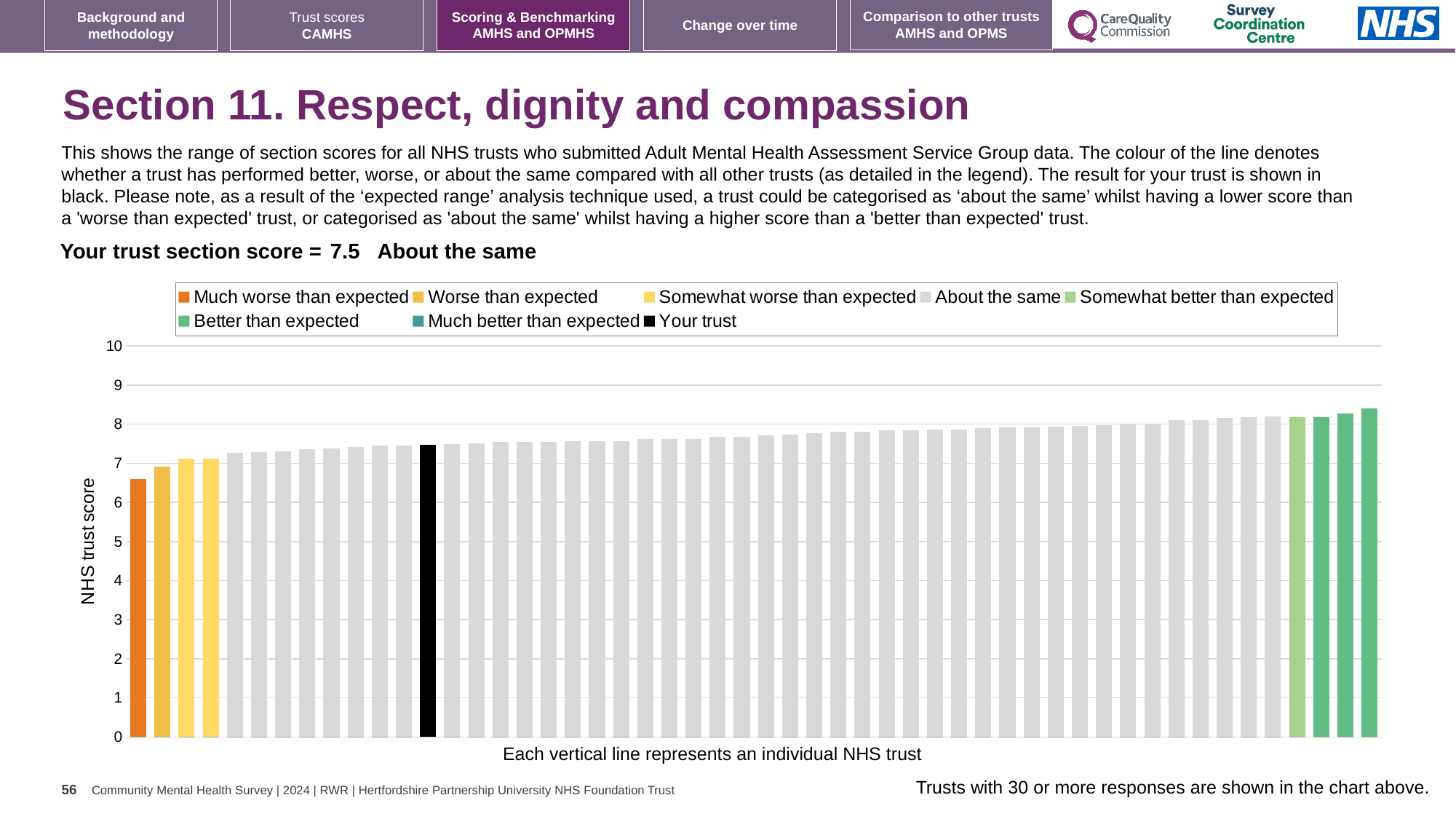
Is the value of the black 'Your trust' bar greater or less than 8? less Which performance category is your trust placed in for this section? About the same What kind of chart is shown on the slide? bar chart Is the value of the black 'Your trust' bar greater or less than 7? greater Is the value of the tallest bar in the chart greater or less than 9? less How many entries does the chart legend list? 8 Do the bar values rise or fall from left to right across the chart? rise What is the section score for your trust? 7.5 Which legend category does the lowest bar in the chart belong to? Much worse than expected What is the label on the vertical axis of the chart? NHS trust score